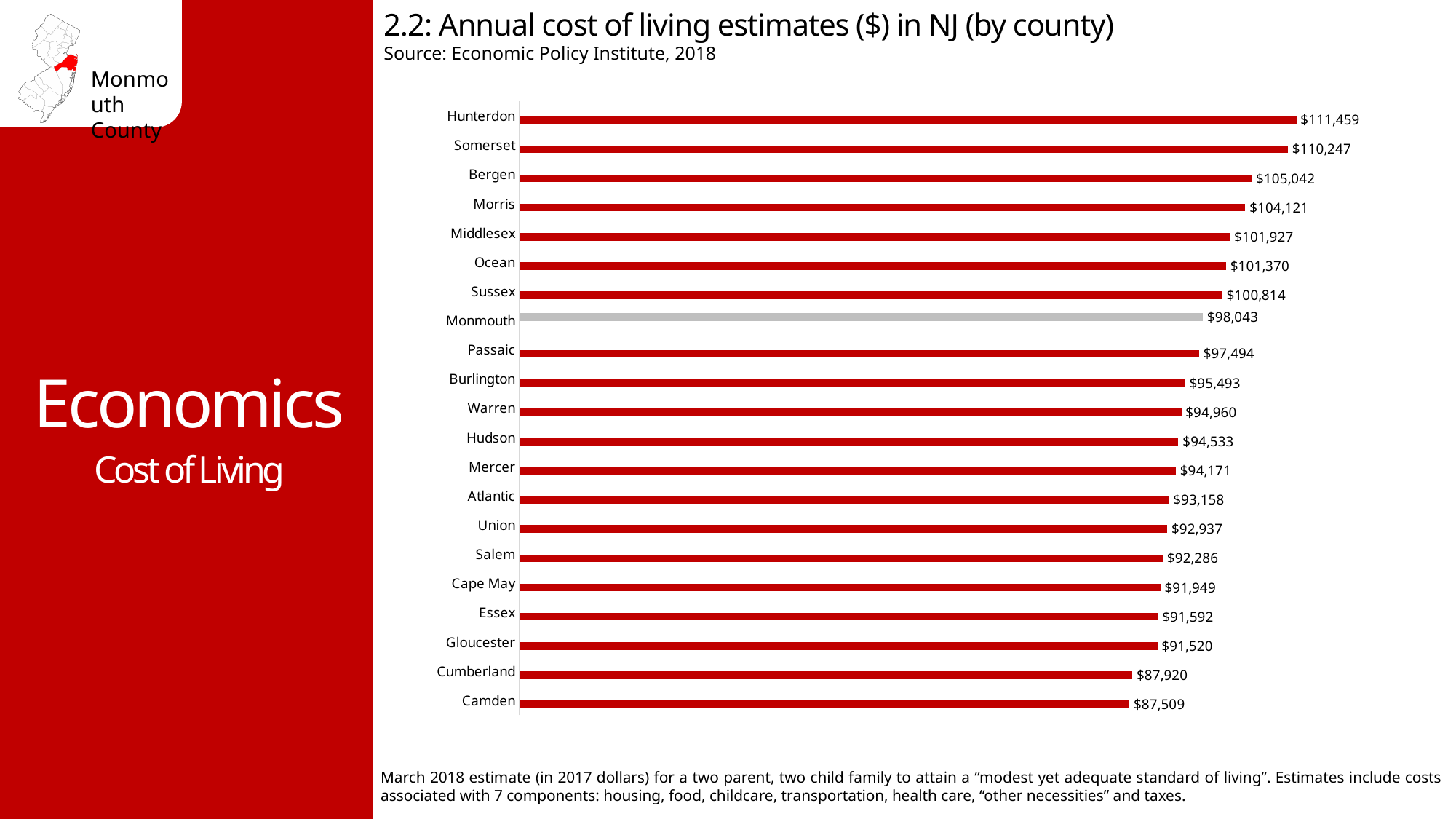
What is the annual cost of living estimate for Bergen County? $105,042 Which county has a higher cost of living estimate, Cumberland or Gloucester? Gloucester What is the annual cost of living estimate for Monmouth County? $98,043 Which county has the lowest annual cost of living estimate? Camden Which county has the highest annual cost of living estimate? Hunterdon How much higher is the cost of living estimate for Hunterdon than for Monmouth? $13,416 What type of chart is used to show the annual cost of living estimates? Bar chart How many counties are shown in the chart? 21 Which county has a higher cost of living estimate, Ocean or Passaic? Ocean What is the annual cost of living estimate for Cape May County? $91,949 What is the difference between the cost of living estimates for Hunterdon and Camden counties? $23,950 Which county's bar is shown in grey rather than red? Monmouth